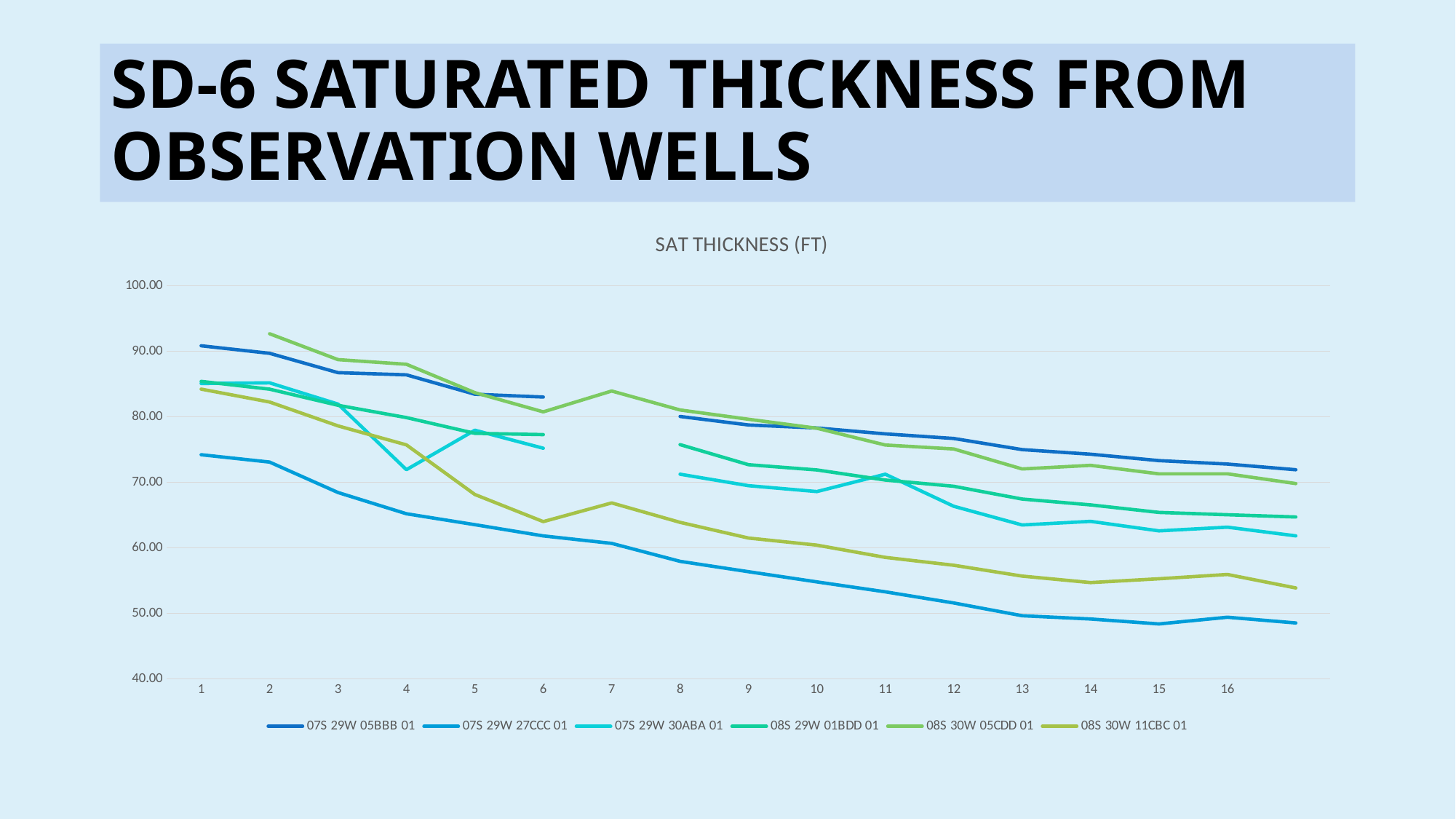
Which series has the highest value at point 2? 08S 30W 05CDD 01 Is the value for 08S 30W 11CBC 01 at point 16 greater or less than 60? less What is the highest value shown on the y axis? 100.00 Does the value for 07S 29W 27CCC 01 rise or fall from point 1 to point 16? fall Is the value for 08S 30W 05CDD 01 at point 2 greater or less than 90? greater At point 8, which series has the larger value, 07S 29W 05BBB 01 or 07S 29W 30ABA 01? 07S 29W 05BBB 01 What is the title of the chart? SAT THICKNESS (FT) Is the value for 07S 29W 27CCC 01 at point 1 greater or less than 70? greater Which series has the lowest value at point 16? 07S 29W 27CCC 01 What kind of chart is shown on the slide? line chart How many series does the legend list? 6